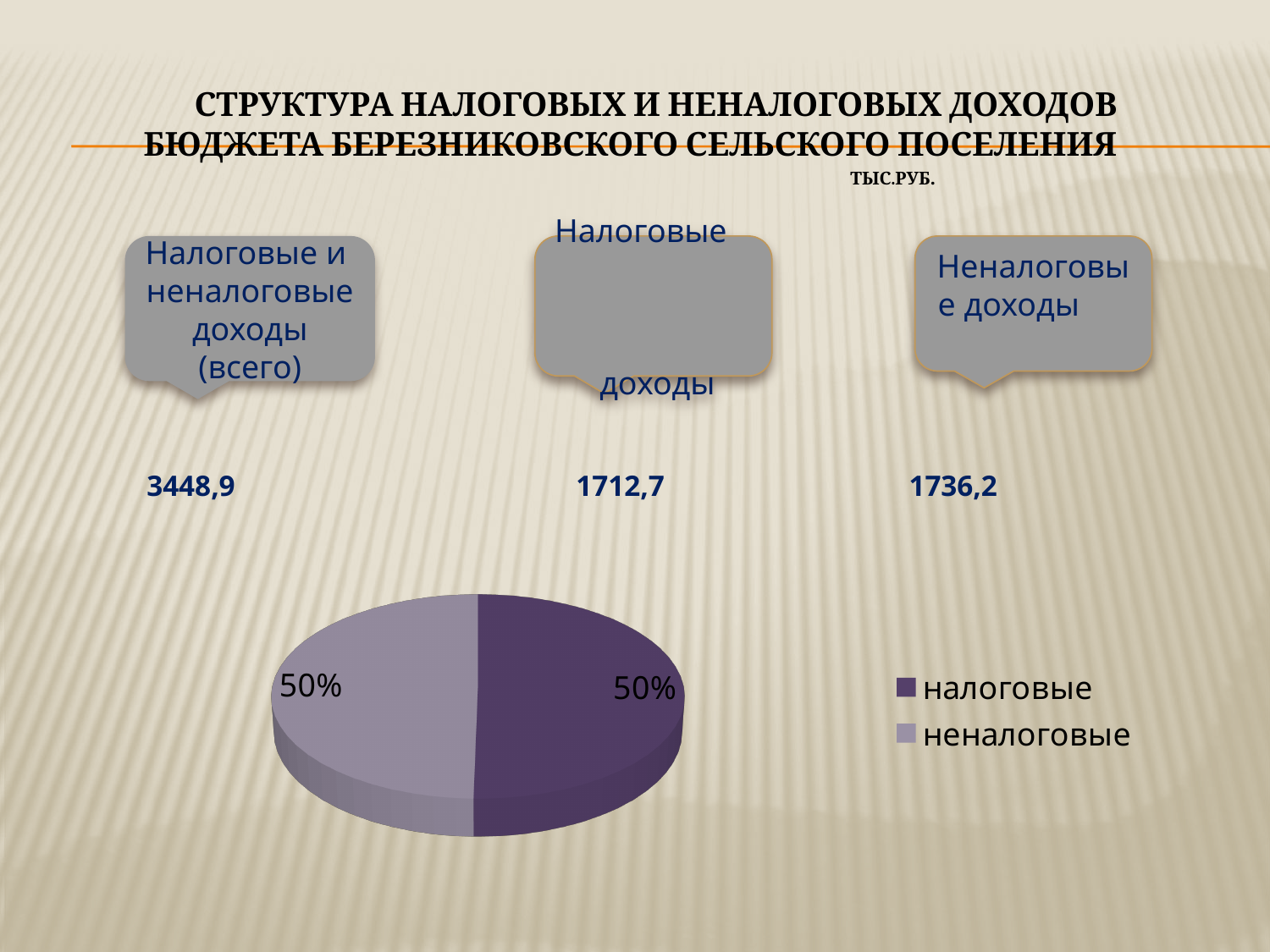
Which legend entry is shown in the darker purple colour? налоговые Is the share of the 'налоговые' slice larger than, smaller than, or equal to the share of the 'неналоговые' slice? equal How many slices does the pie chart have? 2 What share of the pie does the 'неналоговые' slice represent? 50% How many entries does the legend of the pie chart list? 2 What is the combined share of the 'налоговые' and 'неналоговые' slices? 100% What kind of chart is shown on the slide? pie chart Which legend entry is shown in the lighter purple colour? неналоговые What share of the pie does the 'налоговые' slice represent? 50%